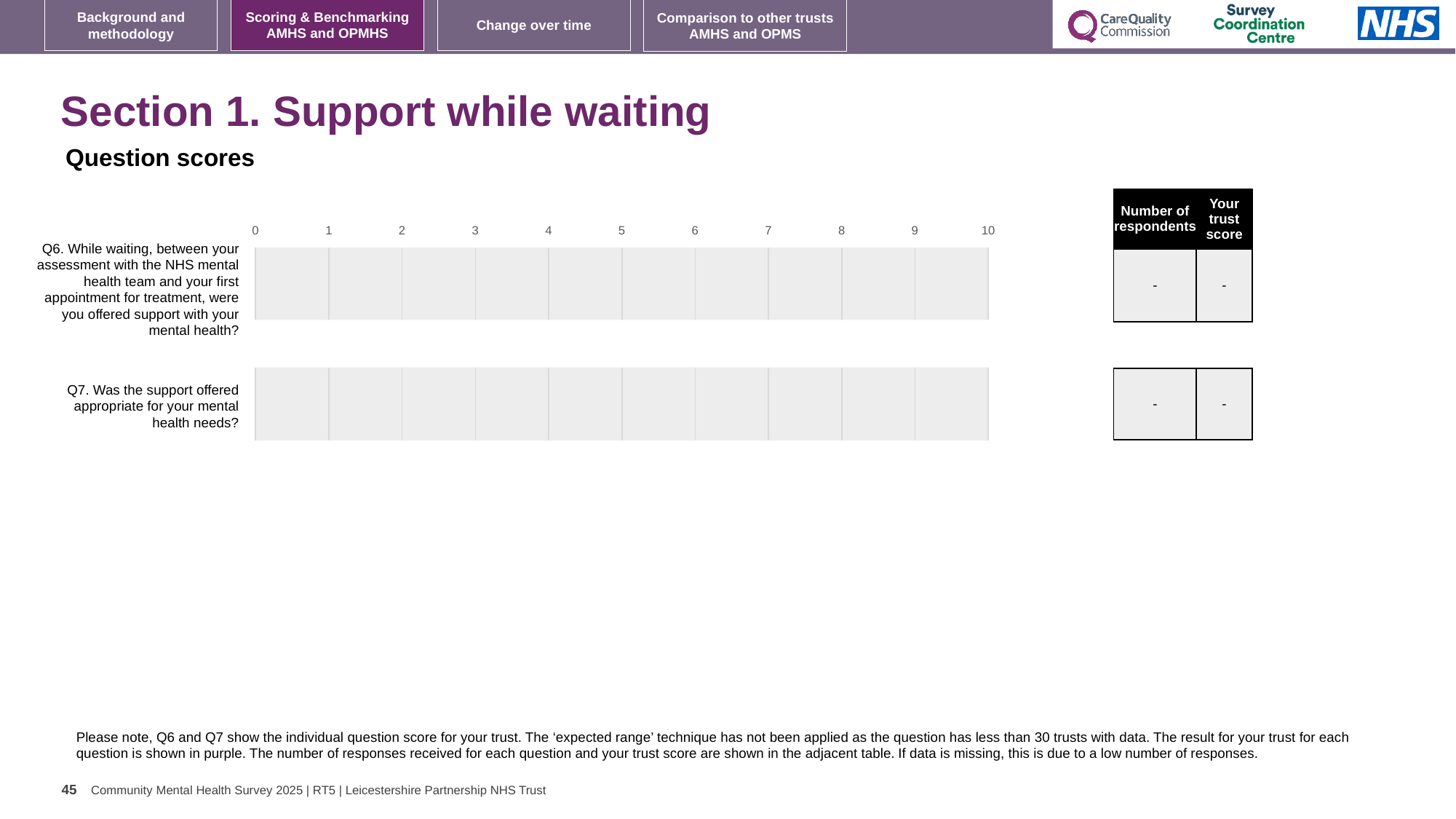
How many questions (categories) are listed on the chart? 2 Is a bar plotted for Q7 on the chart? No Which question label on the chart begins with 'Was the support offered appropriate'? Q7 What is the trust score shown in the table for Q7? - What is the number of respondents shown in the table for Q7? - What is the lowest value shown on the chart's horizontal axis? 0 What is the number of respondents shown in the table for Q6? - What type of chart is shown on the slide? Bar chart What is the highest value shown on the chart's horizontal axis? 10 What is the trust score shown in the table for Q6? -